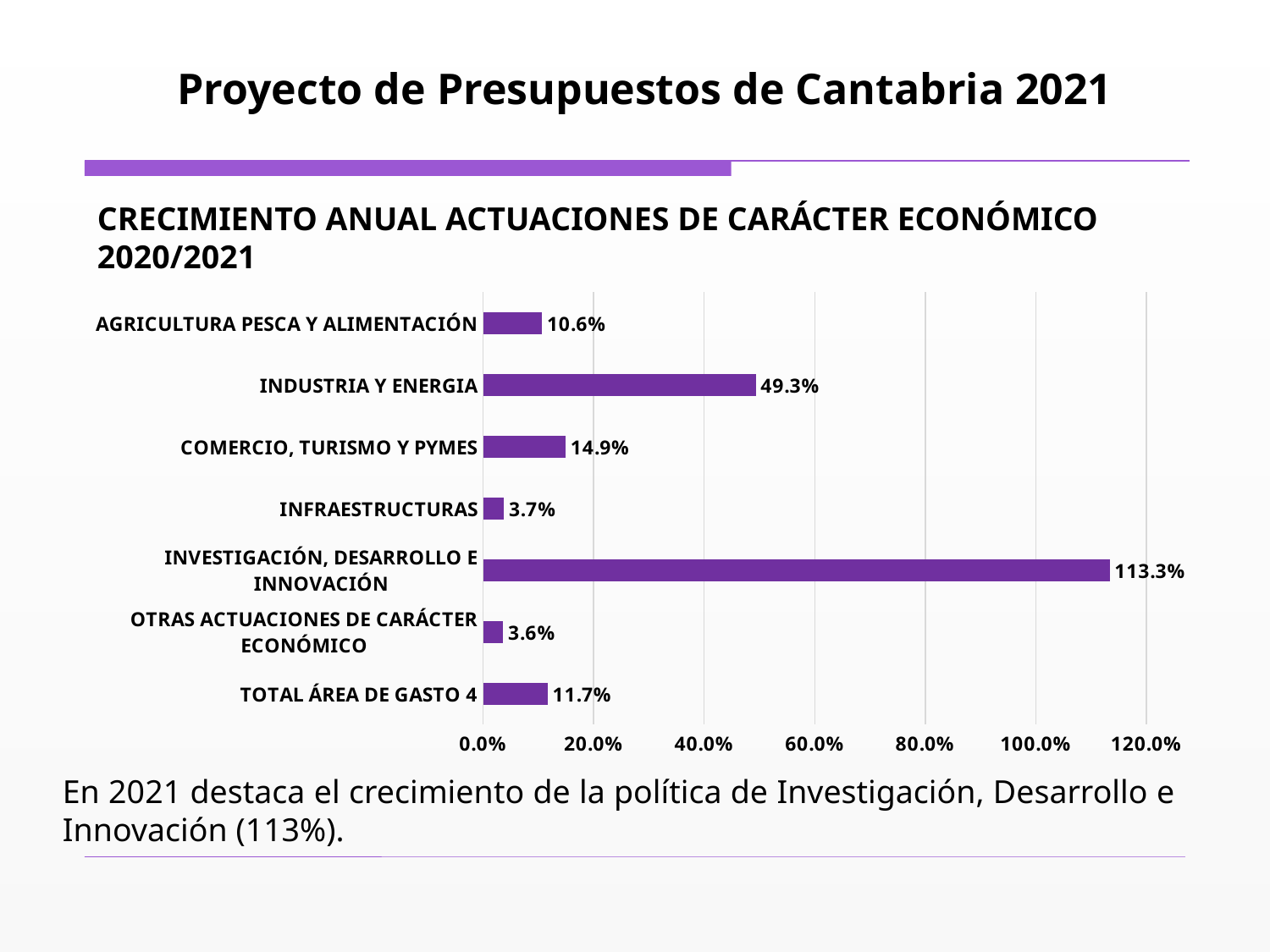
What kind of chart is shown on the slide? bar chart Which is larger, the value for COMERCIO, TURISMO Y PYMES or the value for TOTAL ÁREA DE GASTO 4? COMERCIO, TURISMO Y PYMES What is the title of the chart? CRECIMIENTO ANUAL ACTUACIONES DE CARÁCTER ECONÓMICO 2020/2021 What is the value for TOTAL ÁREA DE GASTO 4? 11.7% Which category has the lowest value? OTRAS ACTUACIONES DE CARÁCTER ECONÓMICO What is the value for COMERCIO, TURISMO Y PYMES? 14.9% Is the value for INVESTIGACIÓN, DESARROLLO E INNOVACIÓN greater or less than 100.0%? greater Which category has the highest value? INVESTIGACIÓN, DESARROLLO E INNOVACIÓN How many categories are shown in the chart? 7 What is the difference between the values for INDUSTRIA Y ENERGIA and AGRICULTURA PESCA Y ALIMENTACIÓN? 38.7% What is the value for INFRAESTRUCTURAS? 3.7% What is the value for INDUSTRIA Y ENERGIA? 49.3%